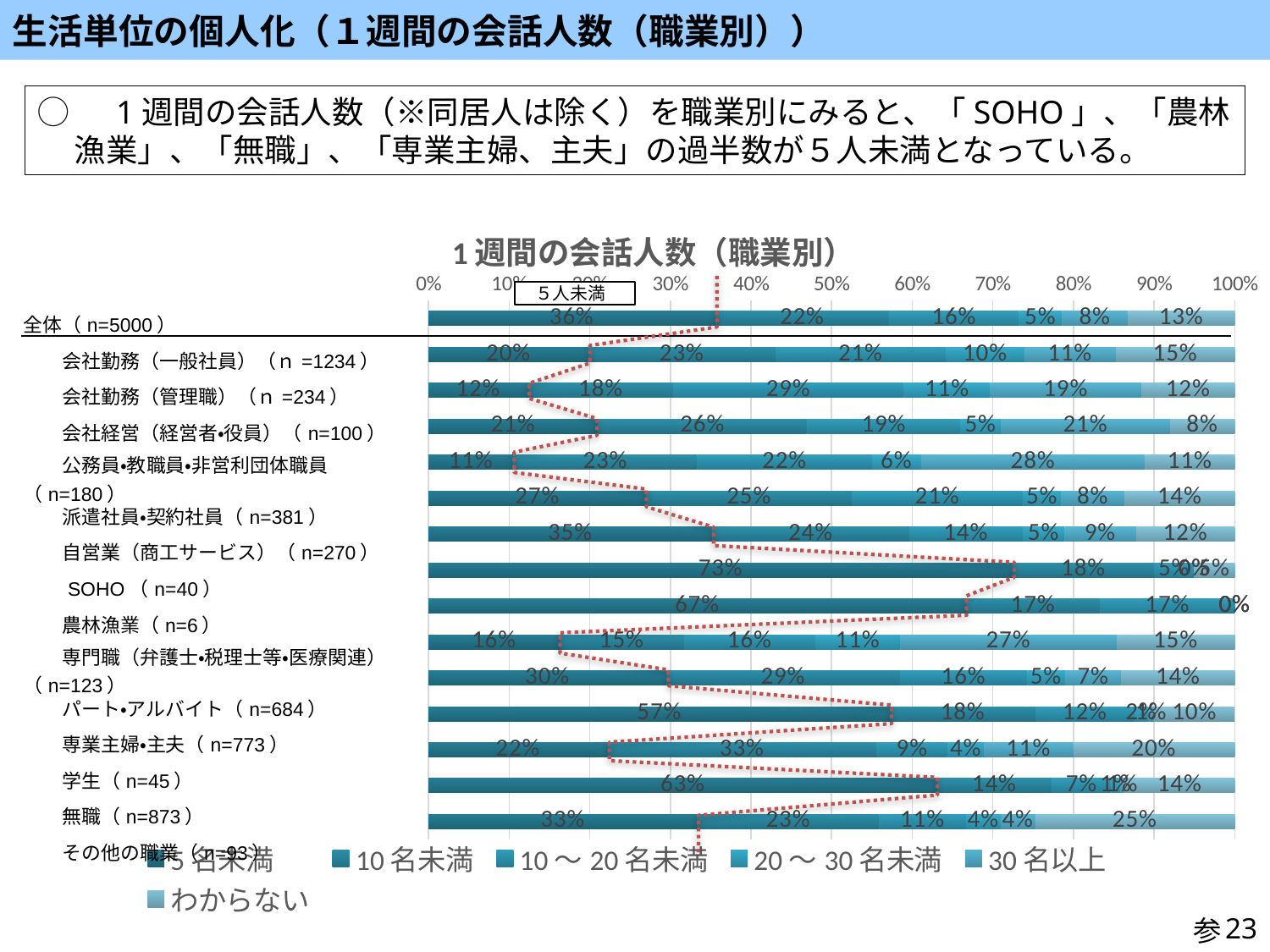
Which occupation category has the highest value for 5名未満? SOHO（n=40） What type of chart is shown on the slide? bar chart What is the title of the chart? １週間の会話人数（職業別） What is the value of 10名未満 for 学生（n=45）? 33% How many occupation categories are plotted in the chart? 15 What is the value of 5名未満 for SOHO（n=40）? 73% What is the value of わからない for 全体（n=5000）? 13% How many series does the legend list? 6 What is the value of 5名未満 for 全体（n=5000）? 36% Which has a larger 5名未満 value, 専業主婦・主夫（n=773） or 学生（n=45）? 専業主婦・主夫（n=773） What is the difference between the 5名未満 value for SOHO（n=40） and for 全体（n=5000）? 37 percentage points What is the value of 5名未満 for 無職（n=873）? 63%